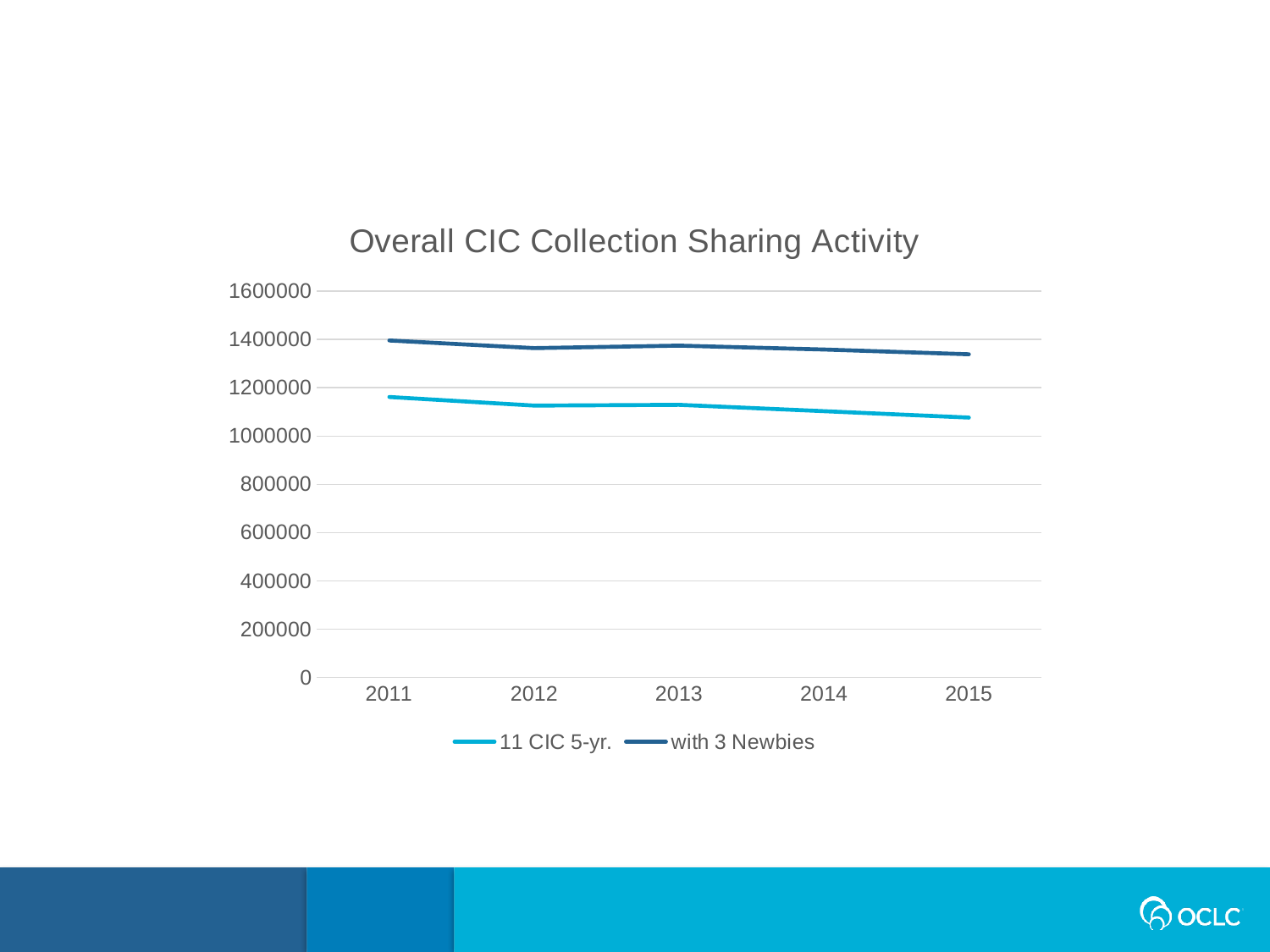
Do the values for '11 CIC 5-yr.' generally rise or fall from 2011 to 2015? fall What kind of chart is shown on the slide? line chart In which year is the 'with 3 Newbies' series at its highest? 2011 Is the value for 'with 3 Newbies' in 2011 greater or less than 1200000? greater Is the value for '11 CIC 5-yr.' in 2011 greater or less than 1000000? greater How many series does the legend list? 2 In which year is the '11 CIC 5-yr.' series at its lowest? 2015 What is the title of the chart? Overall CIC Collection Sharing Activity How many years are shown on the x axis? 5 Is the value for 'with 3 Newbies' in 2015 greater or less than 1400000? less Which series has higher values across all years, '11 CIC 5-yr.' or 'with 3 Newbies'? with 3 Newbies